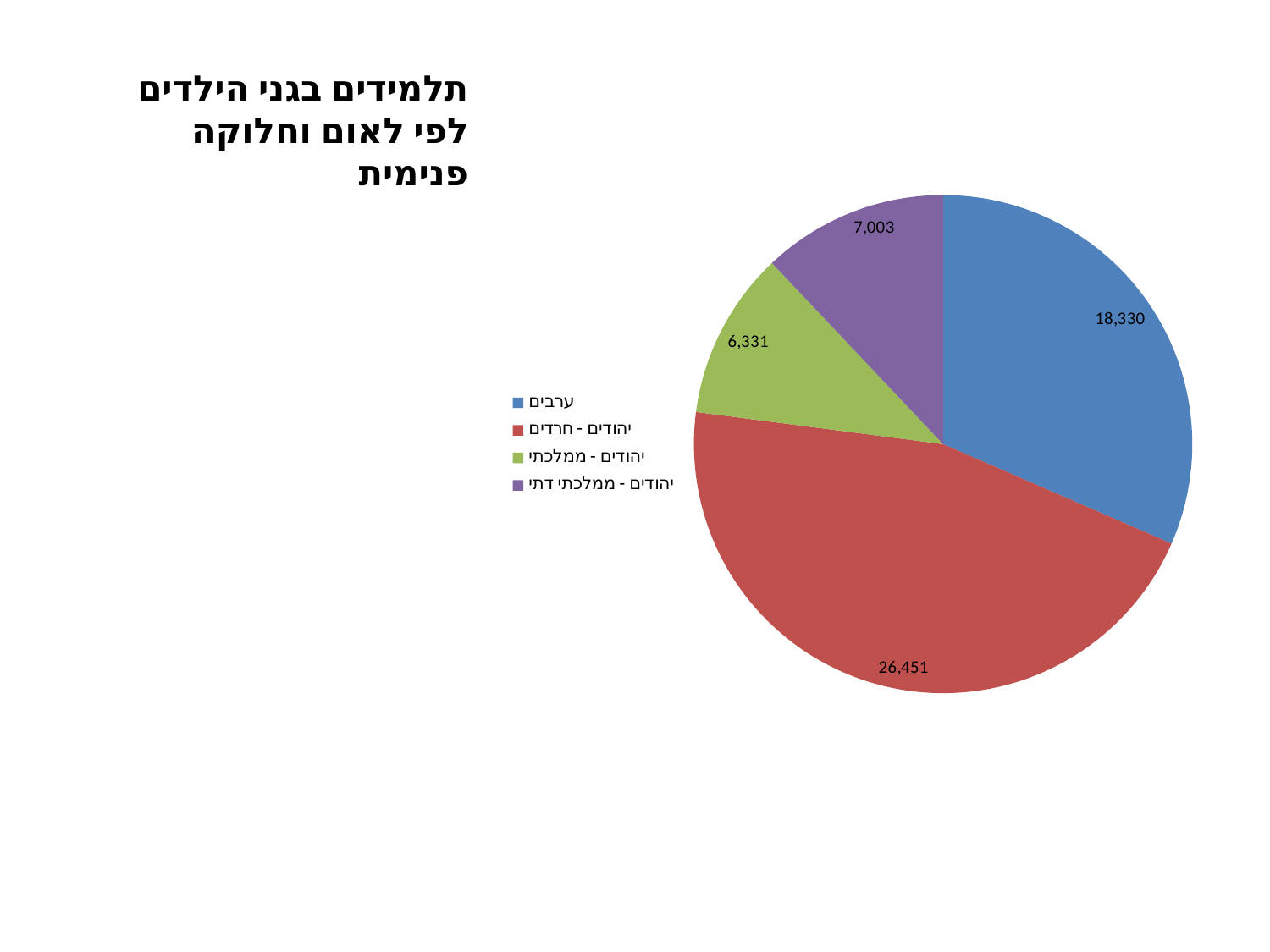
Which is larger, the value for יהודים - ממלכתי דתי or the value for יהודים - ממלכתי? יהודים - ממלכתי דתי What is the difference between the values for יהודים - חרדים and ערבים? 8,121 What is the value for יהודים - חרדים? 26,451 What colour is the slice for ערבים? blue What type of chart is shown on the slide? pie chart What is the value for יהודים - ממלכתי? 6,331 What is the value for ערבים? 18,330 Which category has the largest slice of the pie? יהודים - חרדים What is the value for יהודים - ממלכתי דתי? 7,003 What is the total of all slices in the pie chart? 58,115 How many categories does the pie chart show? 4 Which category has the smallest slice of the pie? יהודים - ממלכתי